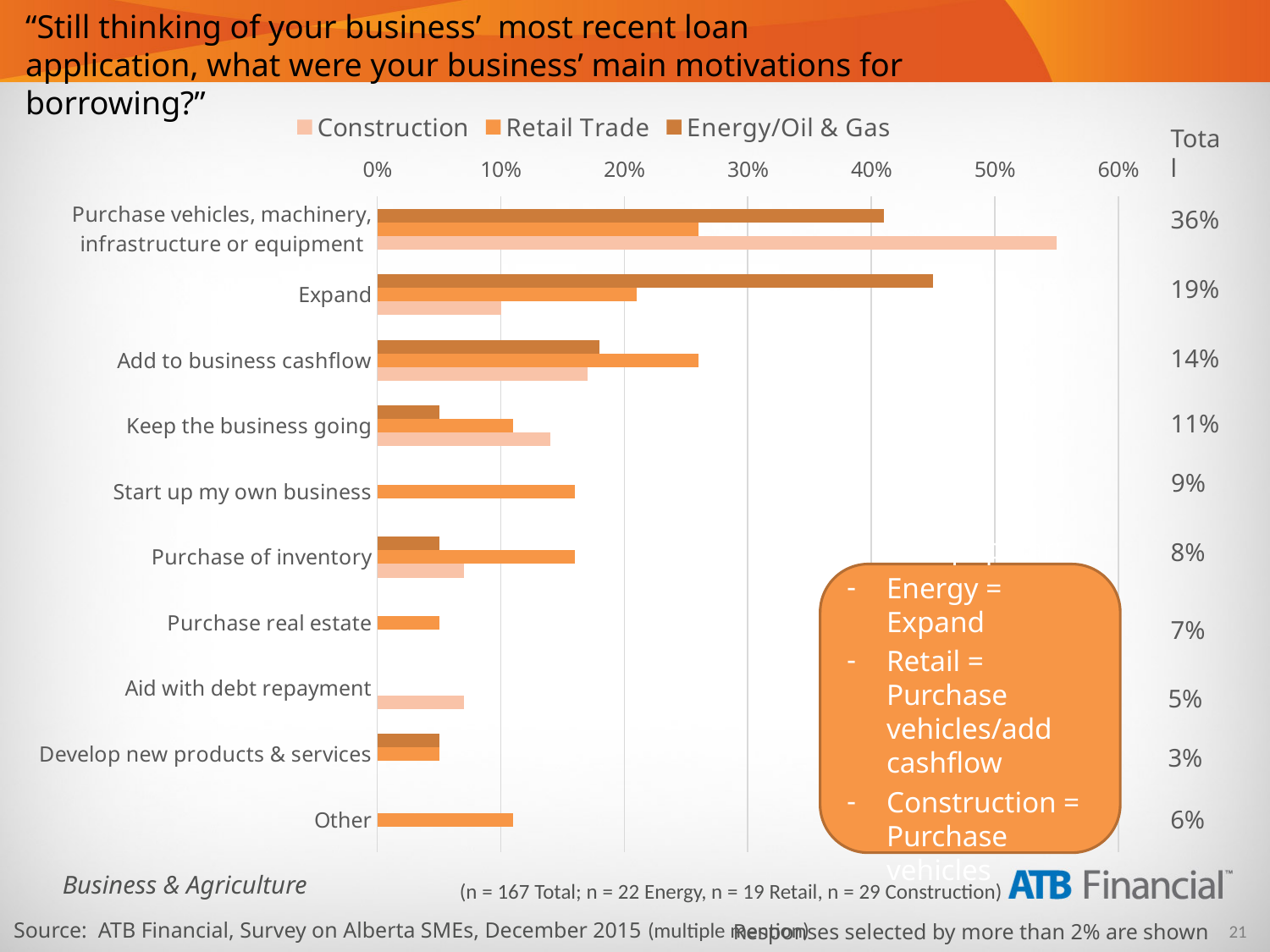
How many series does the chart legend list? 3 Which category has the lowest Total value? Develop new products & services What is the Total value shown for 'Purchase vehicles, machinery, infrastructure or equipment'? 36% Is the Construction value for 'Purchase vehicles, machinery, infrastructure or equipment' greater or less than 50%? greater For 'Purchase vehicles, machinery, infrastructure or equipment', which is larger: the Construction value or the Retail Trade value? Construction What is the Total value shown for 'Expand'? 19% Which three series are listed in the chart legend? Construction, Retail Trade, Energy/Oil & Gas Is the Energy/Oil & Gas value for 'Expand' greater or less than 40%? greater What is the difference between the Total values for 'Expand' and 'Add to business cashflow'? 5% What type of chart is shown on the slide? Bar chart How many motivation categories are plotted on the chart? 10 Which category has the highest Total value? Purchase vehicles, machinery, infrastructure or equipment